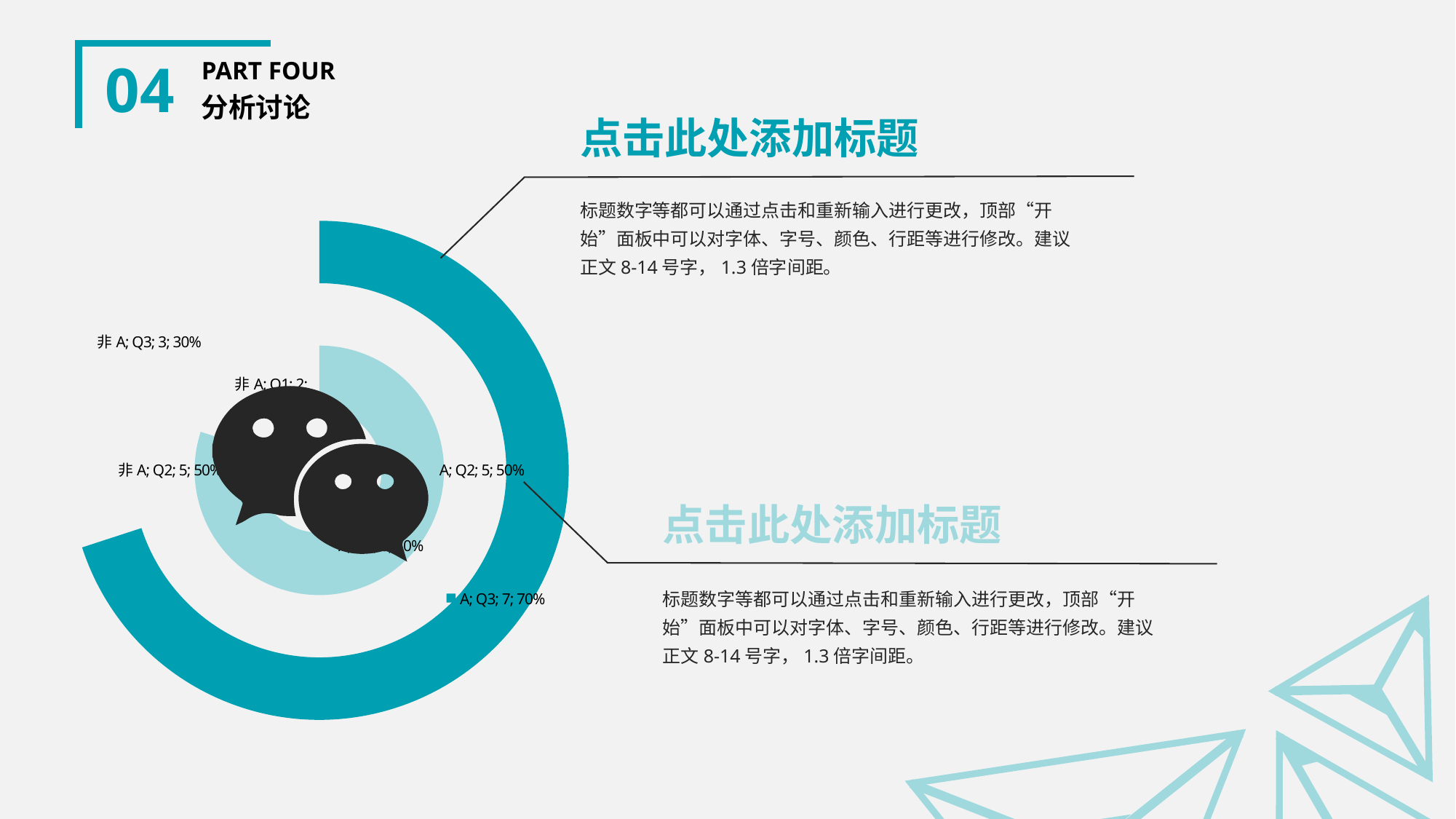
Which is larger in Q3, the value for A or for 非 A? A How many rings (series) does the doughnut chart have? 3 What is the value for series 非 A in Q1? 2 What percentage is shown for series 非 A in Q3? 30% Which is larger for series 非 A, the Q2 value or the Q1 value? Q2 What kind of chart is shown on the left of the slide? Doughnut chart What is the difference between the Q3 and Q2 values for series A? 2 What is the value for series A in Q2? 5 What is the value for series 非 A in Q3? 3 What is the difference between the Q3 values for A and 非 A? 4 What is the value for series A in Q3? 7 What percentage is shown for series A in Q3? 70%